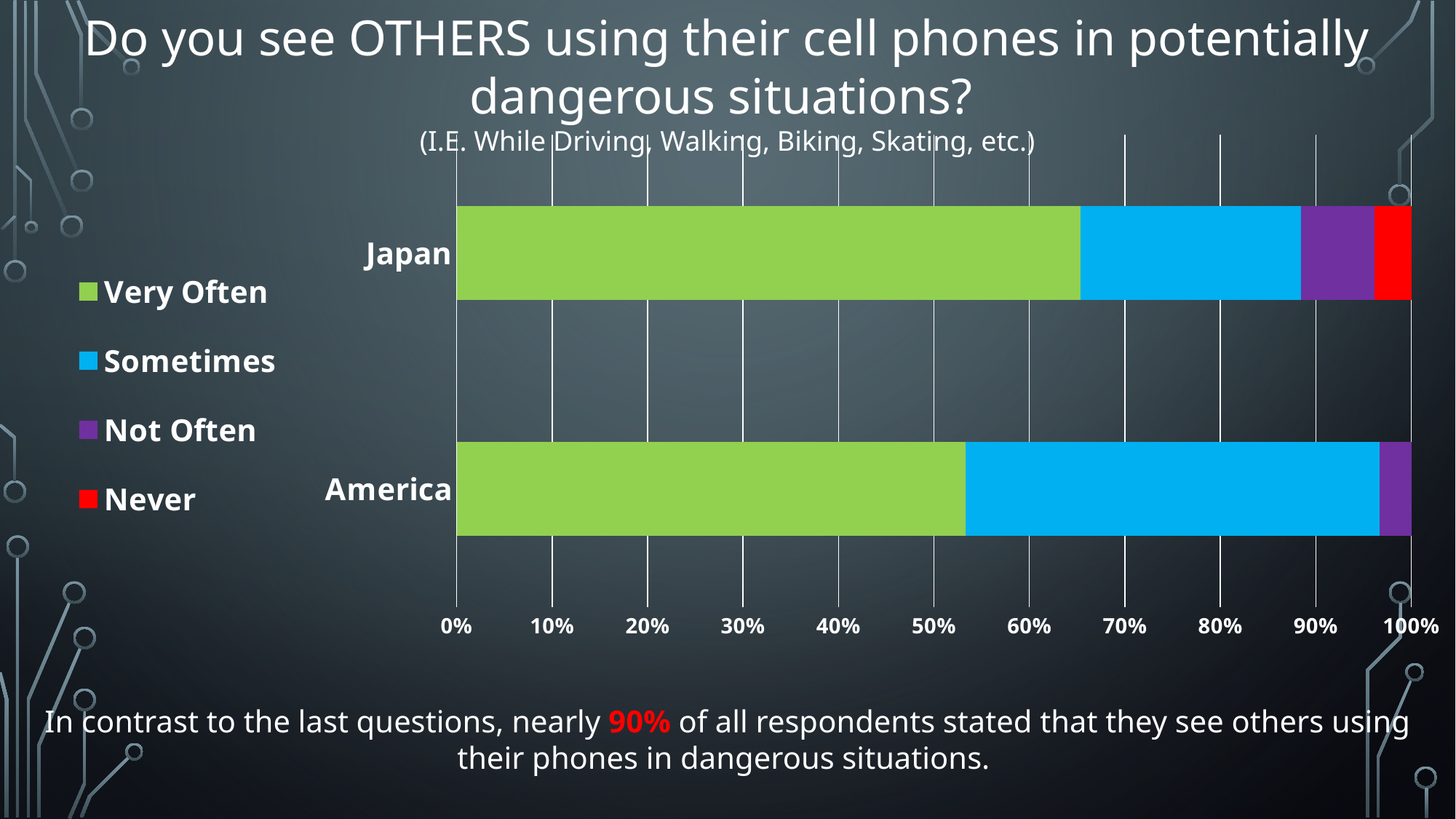
Is the 'Very Often' share for Japan greater or less than 60%? greater Which legend entry is shown in red? Never Which response is the smallest segment in the Japan bar? Never What is the total of the stacked bar for Japan? 100% Which country has the larger 'Sometimes' share, Japan or America? America Which colour represents 'Not Often' in the legend? Purple Which country has the larger 'Very Often' share, Japan or America? Japan What kind of chart is shown on the slide? Stacked bar chart Is the 'Very Often' share for America greater or less than 50%? greater Is the 'Very Often' share for America greater or less than 60%? less How many series does the legend list? 4 How many countries (categories) are plotted on the chart? 2